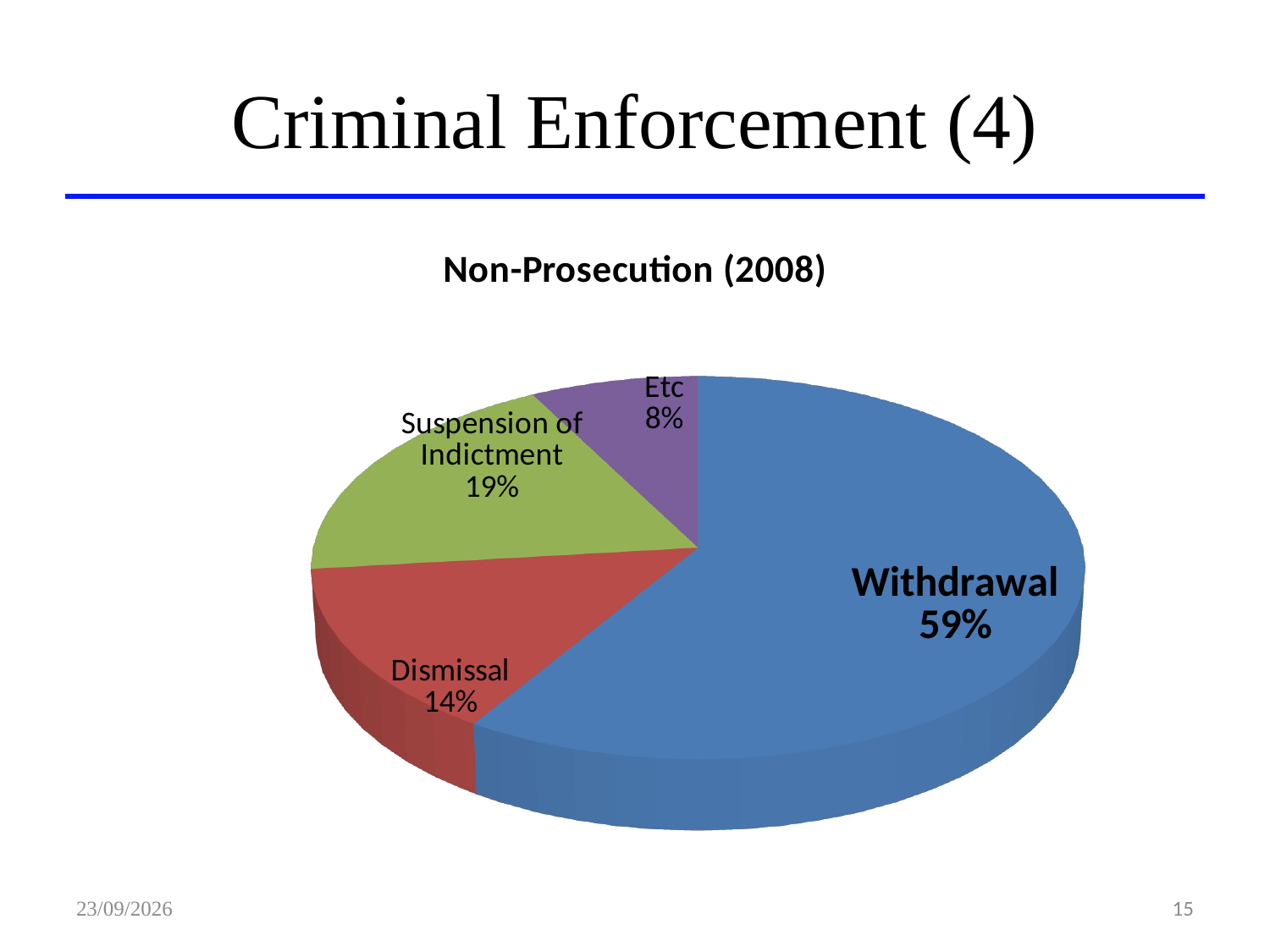
What share of the pie does Withdrawal represent? 59% Which category has the largest share of the pie? Withdrawal What share of the pie does Suspension of Indictment represent? 19% What share of the pie does Etc represent? 8% What colour is the Withdrawal slice? blue How many slices does the pie chart have? 4 What is the title of the chart? Non-Prosecution (2008) What is the difference in percentage points between Withdrawal and Suspension of Indictment? 40 What kind of chart is shown on the slide? pie chart Which is larger, the share for Dismissal or the share for Suspension of Indictment? Suspension of Indictment Which category has the smallest share of the pie? Etc